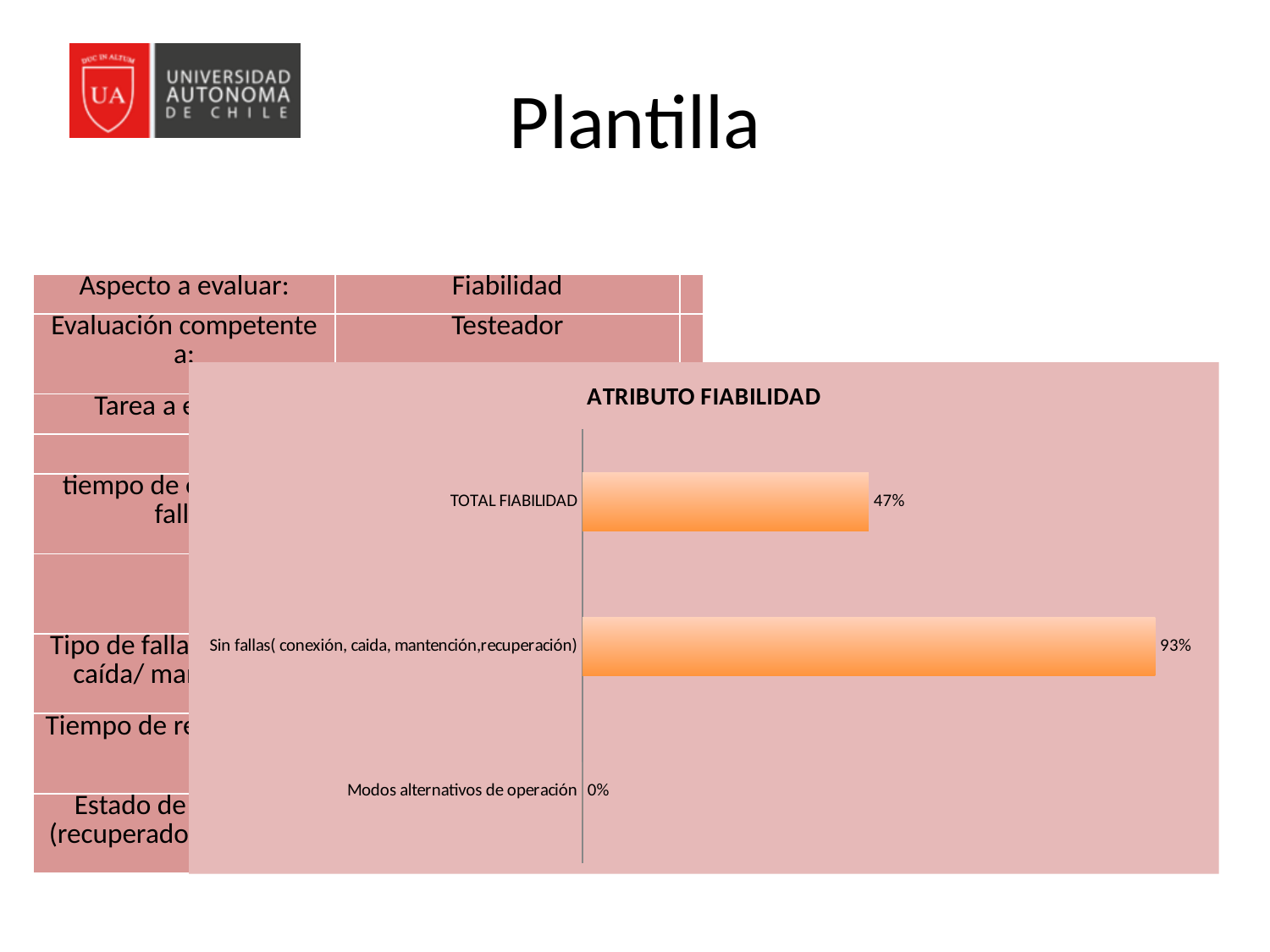
Which category has the highest value in the chart? Sin fallas( conexión, caida, mantención,recuperación) What is the difference between the value for Sin fallas( conexión, caida, mantención,recuperación) and TOTAL FIABILIDAD? 46% What colour are the bars in the chart? Orange Which category has the lowest value in the chart? Modos alternativos de operación What is the value for TOTAL FIABILIDAD in the ATRIBUTO FIABILIDAD chart? 47% How many categories are shown in the chart? 3 What is the value for Sin fallas( conexión, caida, mantención,recuperación)? 93% What is the title of the chart? ATRIBUTO FIABILIDAD What is the value for Modos alternativos de operación? 0% Which is larger, the value for TOTAL FIABILIDAD or the value for Modos alternativos de operación? TOTAL FIABILIDAD What kind of chart is shown on the slide? Bar chart